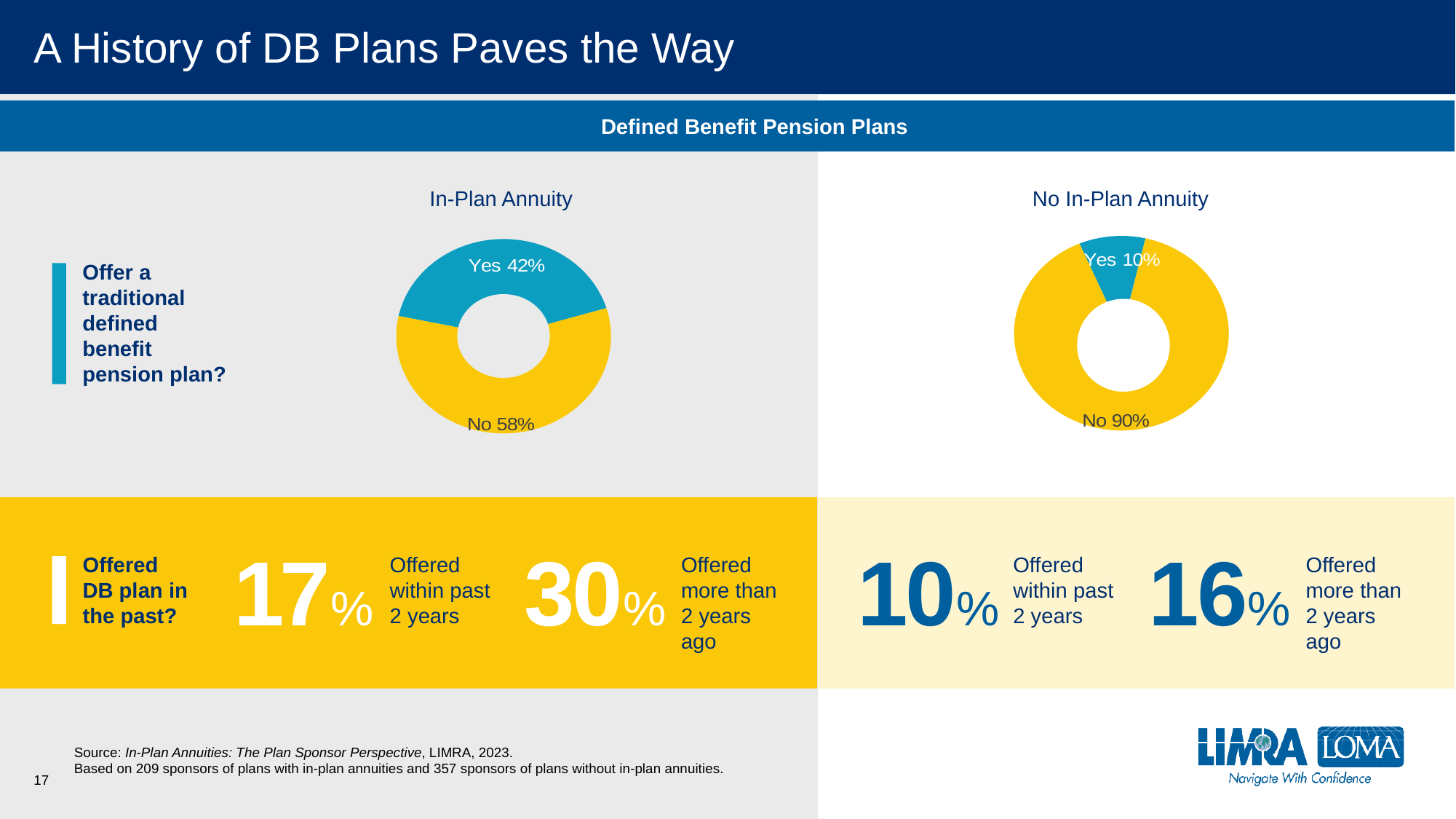
In the In-Plan Annuity chart, what share of sponsors answered Yes to offering a traditional defined benefit pension plan? 42% In the In-Plan Annuity chart, what is the difference in percentage points between the No and Yes shares? 16 Which chart shows a larger Yes share, In-Plan Annuity or No In-Plan Annuity? In-Plan Annuity How many slices does the In-Plan Annuity chart have? 2 In the In-Plan Annuity chart, what share of sponsors answered No? 58% In the No In-Plan Annuity chart, what share of sponsors answered No? 90% In the In-Plan Annuity chart, which response has the larger share, Yes or No? No What kind of chart is used to show whether sponsors offer a traditional defined benefit pension plan? Doughnut (pie) chart In the No In-Plan Annuity chart, what is the difference in percentage points between the No and Yes shares? 80 What colour is the Yes slice in the In-Plan Annuity chart? Blue In the No In-Plan Annuity chart, what share of sponsors answered Yes? 10% In the No In-Plan Annuity chart, which response has the smallest share? Yes